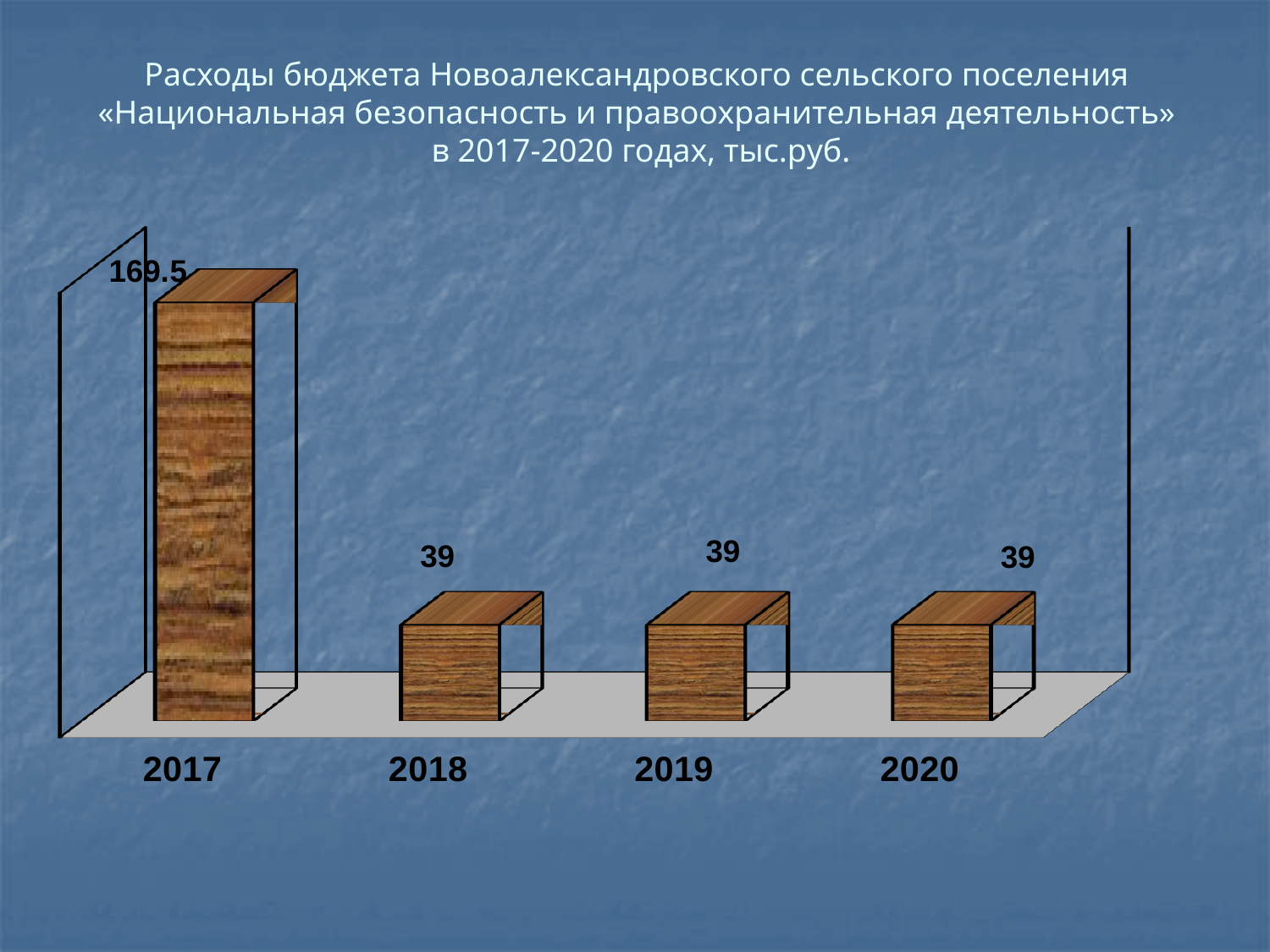
Do the values change between 2018 and 2020? No, they stay at 39 Which is larger, the value for 2017 or the value for 2019? 2017 In what units are the values given according to the title? тыс.руб. What is the difference between the values for 2017 and 2018? 130.5 What kind of chart is shown on the slide? bar chart What is the value for 2017? 169.5 What is the value for 2018? 39 What is the value for 2020? 39 Do the values rise or fall from 2017 to 2018? fall What is the total of the values for 2018, 2019 and 2020? 117 Which year has the highest value? 2017 How many years are shown on the x axis? 4